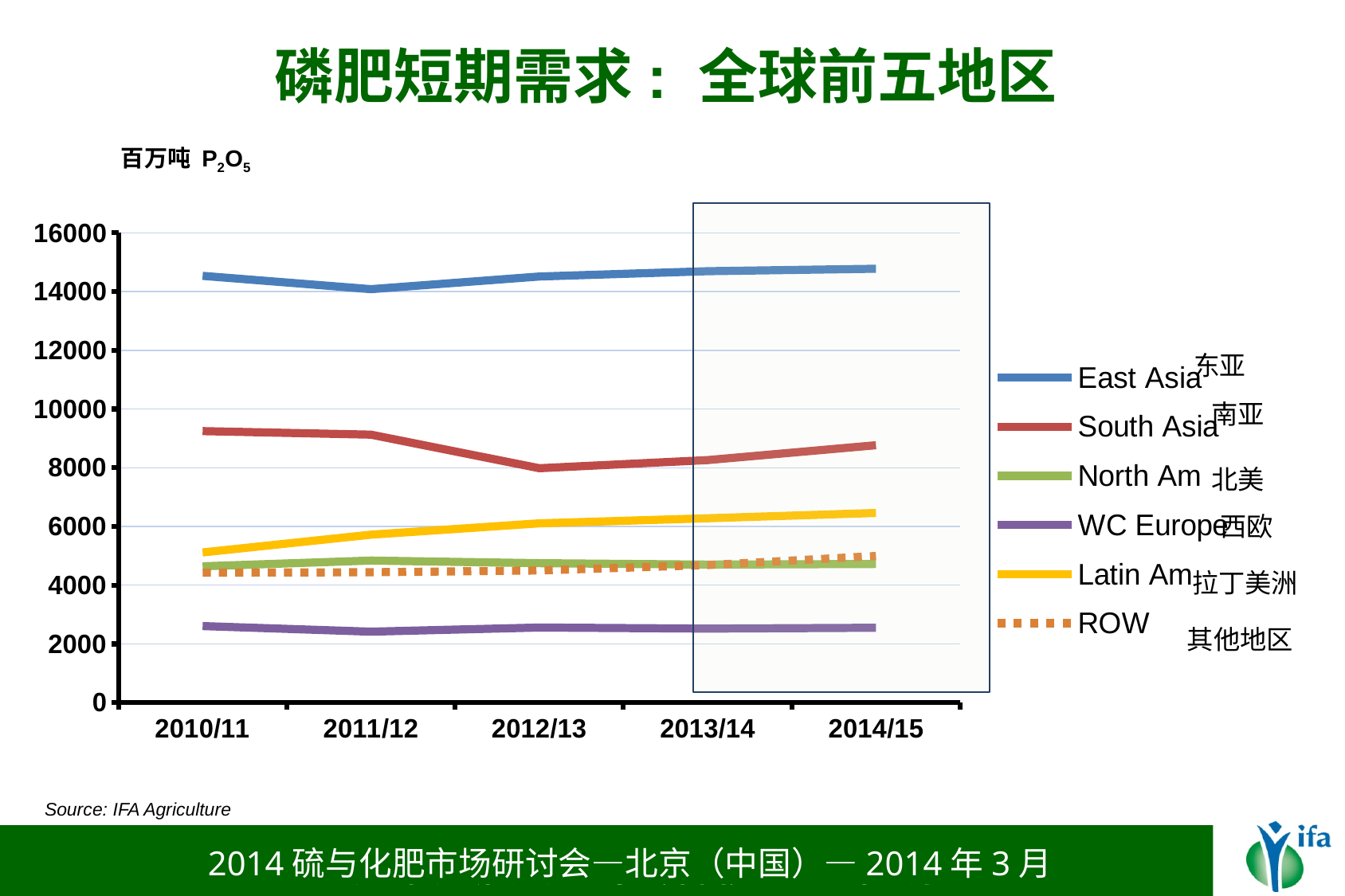
In 2014/15, which is larger: South Asia or Latin Am? South Asia Which region has the highest phosphate demand across all years shown? East Asia Is the value for South Asia in 2012/13 greater or less than 10000? less What kind of chart is shown on the slide? line chart How many series does the legend list? 6 Is the value for Latin Am in 2014/15 greater or less than 6000? greater How many years are shown along the x axis? 5 Which series is drawn with a dotted line in the legend? ROW Is the value for East Asia in 2014/15 greater or less than 14000? greater Which region has the lowest phosphate demand across all years shown? WC Europe Does the Latin Am line rise or fall from 2010/11 to 2014/15? rise